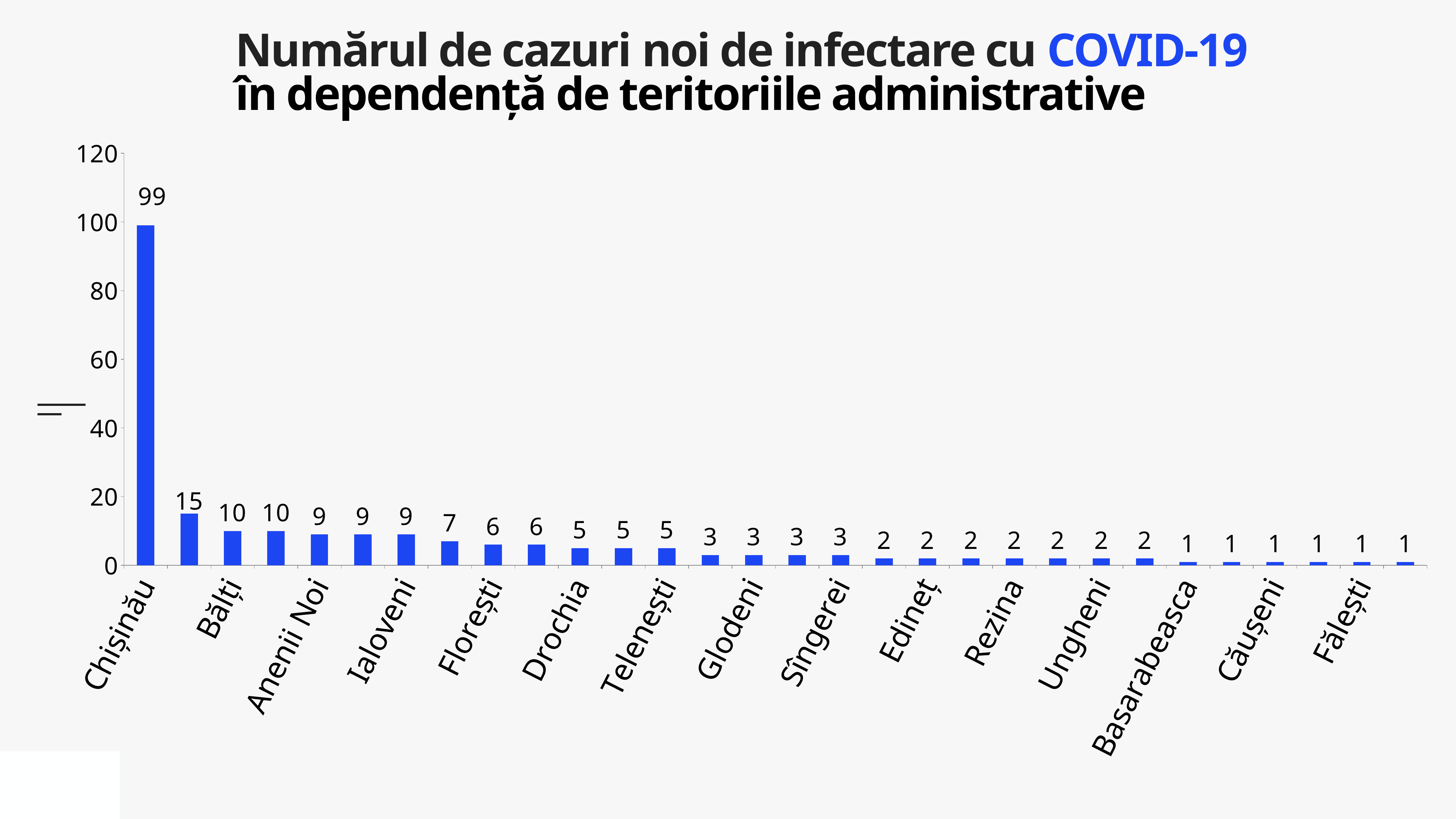
Do the values rise or fall from left to right along the x axis? fall What is the value for Drochia? 5 How many bars are plotted in the chart? 30 What is the value for Bălți? 10 Is the value for Chișinău greater or less than 80? greater What is the value for Anenii Noi? 9 What is the value for Fălești? 1 What is the difference between the values for Chișinău and Bălți? 89 What kind of chart is shown on the slide? bar chart What is the value for Chișinău? 99 Which is larger, the value for Chișinău or the value for Florești? Chișinău Which territory has the highest number of new cases? Chișinău